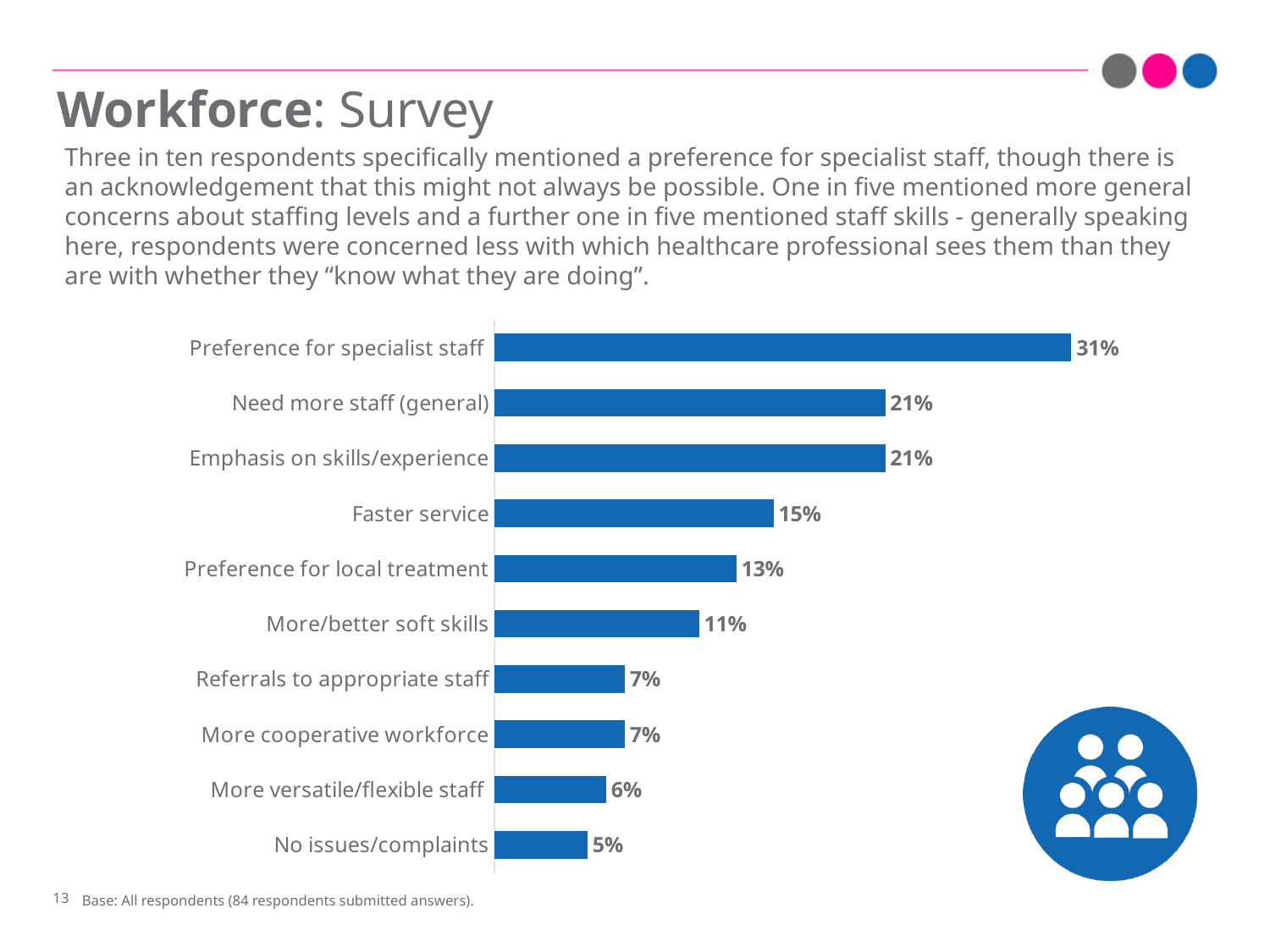
What is the difference between 'Preference for specialist staff' and 'Need more staff (general)'? 10% What is the value for 'Faster service'? 15% What is the value for 'No issues/complaints'? 5% Which is larger: 'Faster service' or 'Preference for local treatment'? Faster service What kind of chart is shown on the slide? Bar chart What is the value for 'More/better soft skills'? 11% Which category has the lowest value? No issues/complaints What is the difference between 'Preference for local treatment' and 'More versatile/flexible staff'? 7% What colour are the bars in the chart? Blue What percentage of respondents mentioned a preference for specialist staff? 31% How many categories are shown in the chart? 10 Which category has the highest value? Preference for specialist staff